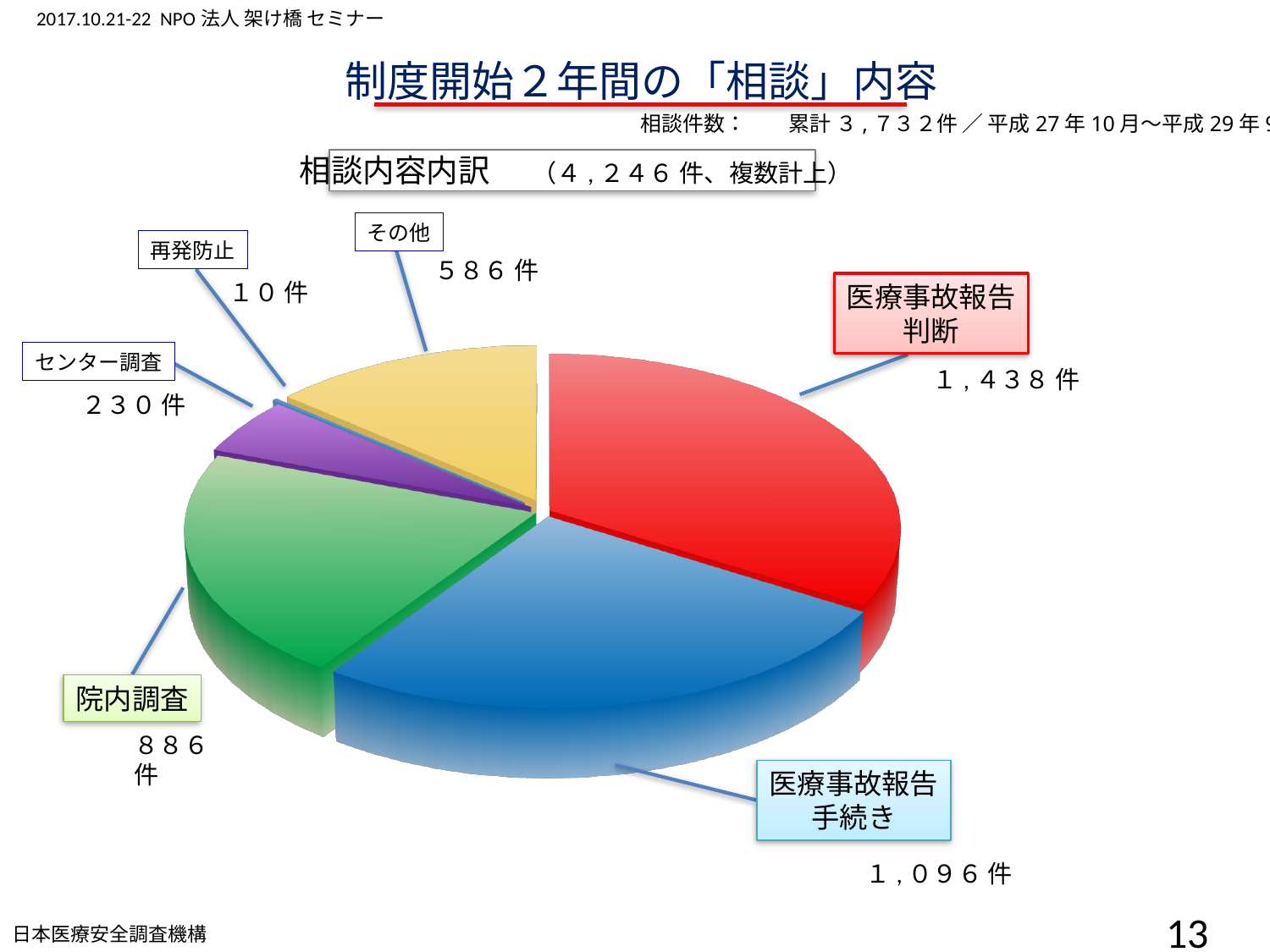
What is the value for 医療事故報告判断? １，４３８件 What kind of chart is shown on the slide? pie chart What is the value for 医療事故報告手続き? １，０９６件 Which category has the smallest slice? 再発防止 How many slices does the pie chart have? 6 What is the value for 再発防止? １０件 What is the value for センター調査? ２３０件 What is the value for その他? ５８６件 Which category has the largest slice? 医療事故報告判断 Which is larger, 院内調査 or その他? 院内調査 What is the value for 院内調査? ８８６件 What is the difference between 医療事故報告判断 and 医療事故報告手続き? ３４２件